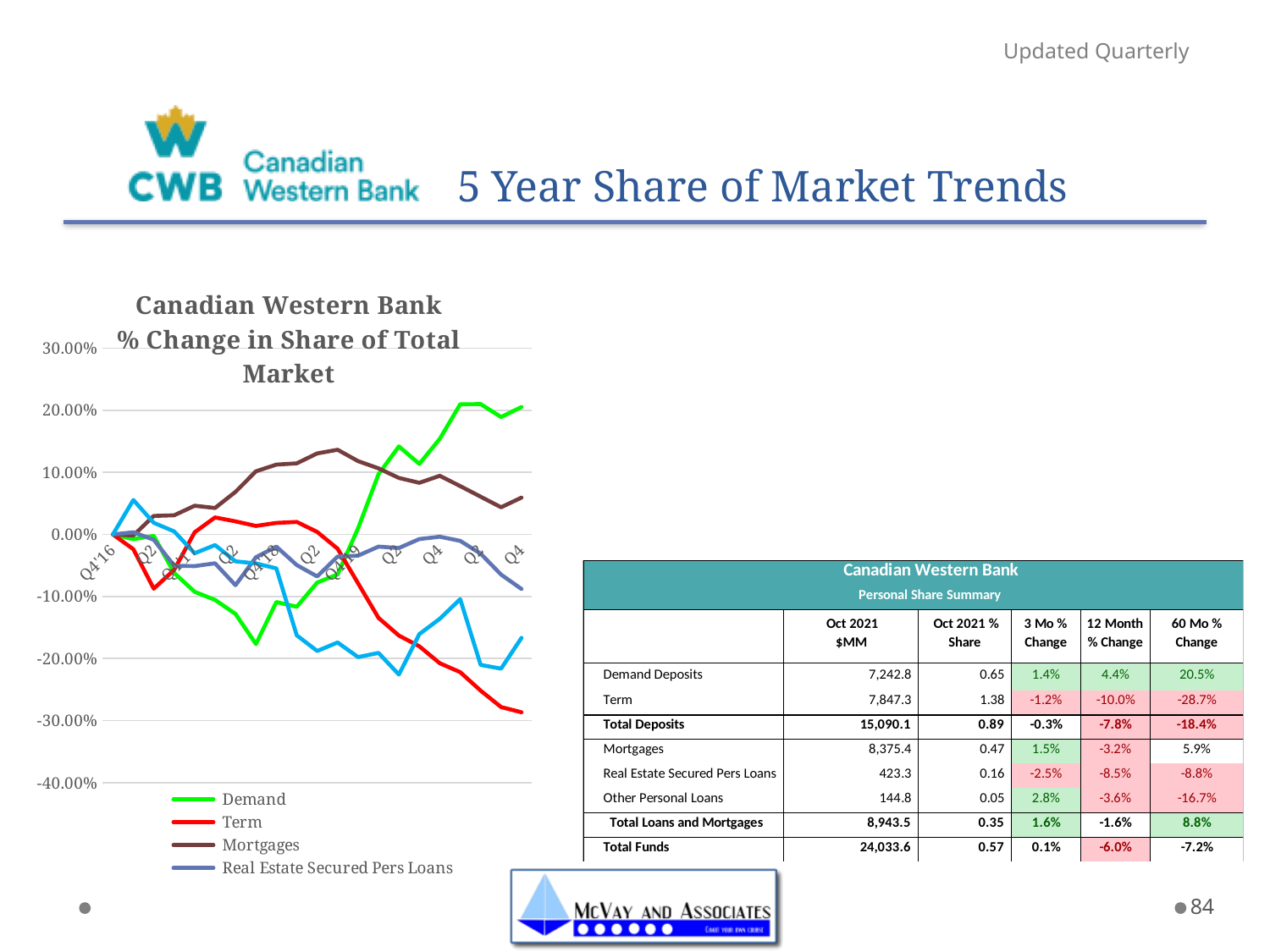
At the right end of the chart, which series is higher: Demand or Term? Demand Does the Demand series generally rise or fall across the chart from left to right? rise Which series ends at the lowest value at the right end of the chart? Term What kind of chart is shown on the slide? line chart Is the final value of the Real Estate Secured Pers Loans series greater or less than 0.00%? less Is the final value of the Term series greater or less than -20.00%? less What is the title of the chart? Canadian Western Bank % Change in Share of Total Market Which colour is used for the Term series in the chart? red Is the final value of the Demand series greater or less than 10.00%? greater Does the Term series generally rise or fall across the chart from left to right? fall How many series does the chart legend list? 4